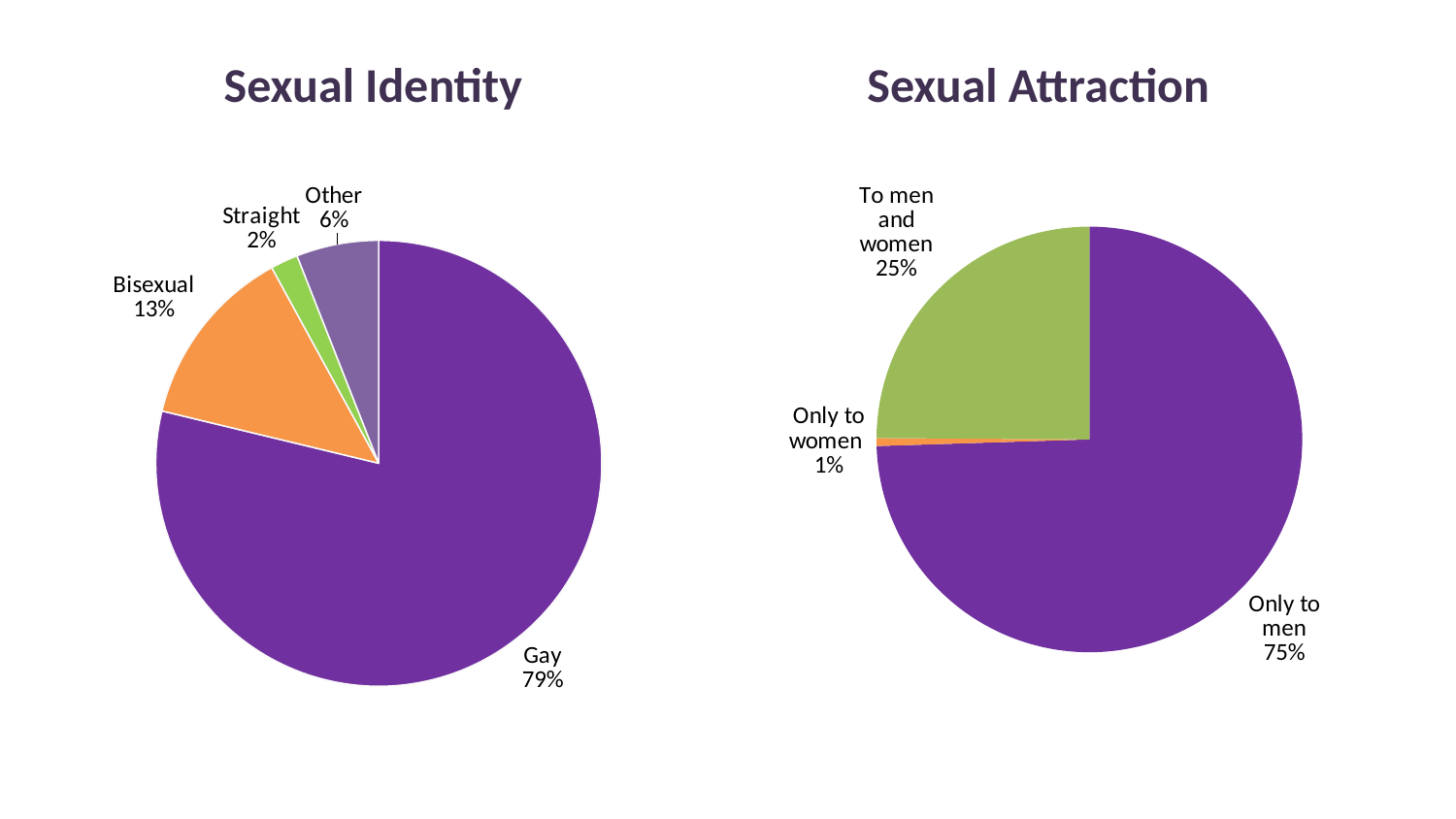
In the Sexual Attraction chart, what percentage is labelled 'To men and women'? 25% In the Sexual Identity chart, which category has the largest slice? Gay Which is larger: the Other slice in the Sexual Identity chart or the 'Only to women' slice in the Sexual Attraction chart? Other In the Sexual Identity chart, which category has the smallest slice? Straight In the Sexual Identity chart, what percentage is labelled Gay? 79% In the Sexual Identity chart, what percentage is labelled Bisexual? 13% In the Sexual Attraction chart, what is the difference between 'Only to men' and 'To men and women'? 50% In the Sexual Identity chart, what is the difference between the Bisexual and Other percentages? 7% In the Sexual Attraction chart, which category has the largest slice? Only to men In the Sexual Attraction chart, what percentage is labelled 'Only to women'? 1% What type of chart is used for Sexual Attraction? Pie chart In the Sexual Identity chart, how many slices does the pie have? 4